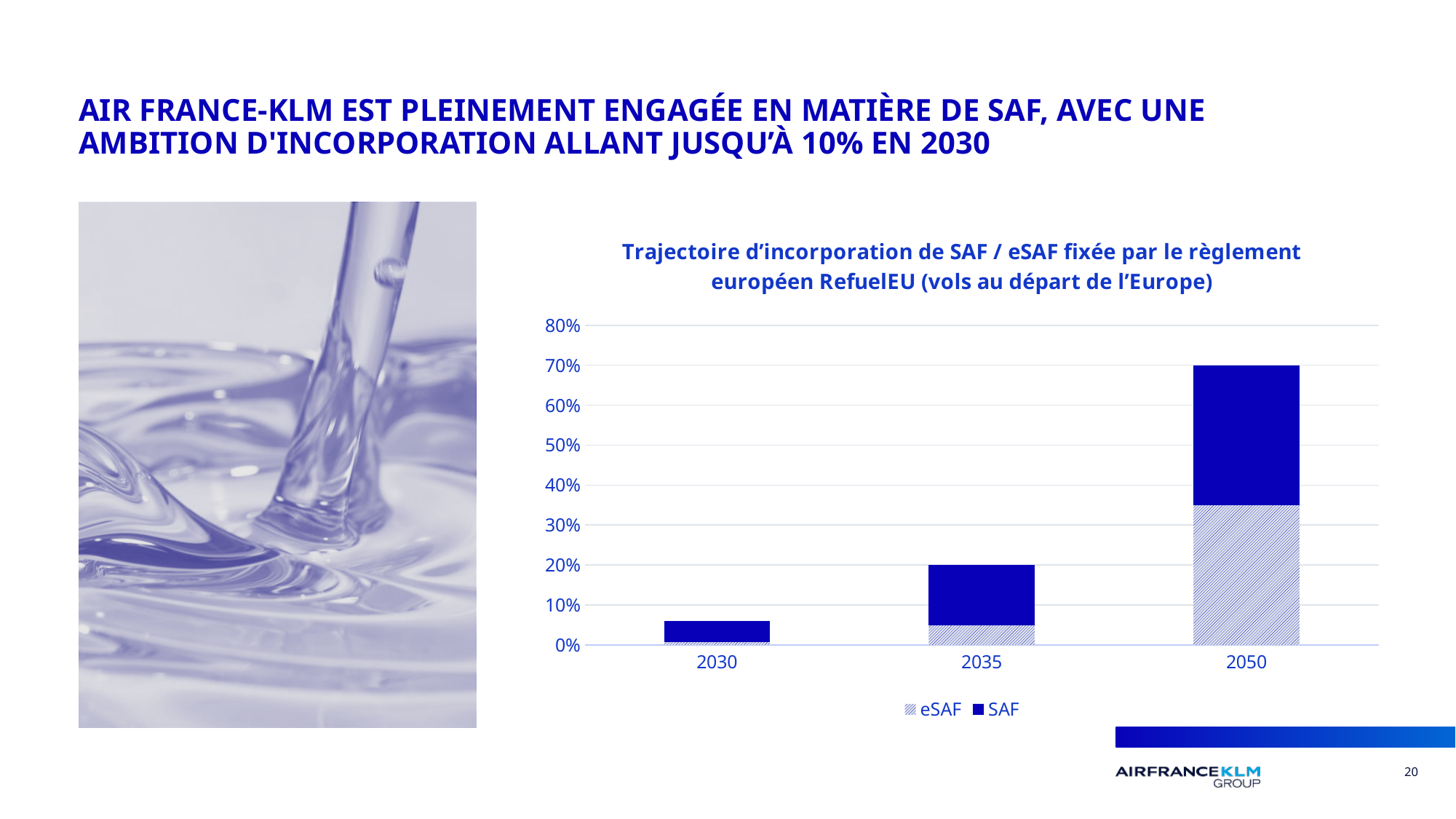
How many series does the chart legend list? 2 Is the eSAF value for 2050 greater or less than 30%? greater What kind of chart is shown on the slide? Stacked bar chart Is the eSAF value for 2035 greater or less than 10%? less Which year has the lowest total SAF / eSAF incorporation in the chart? 2030 Do the total values rise or fall from 2030 to 2050? rise What is the total height of the stacked bar for 2035? 20% What is the total height of the stacked bar for 2050? 70% Which year has the highest total SAF / eSAF incorporation in the chart? 2050 How many years are shown on the x axis of the chart? 3 Which series is shown with a hatched pattern in the legend? eSAF Is the total value for 2030 greater or less than 10%? less